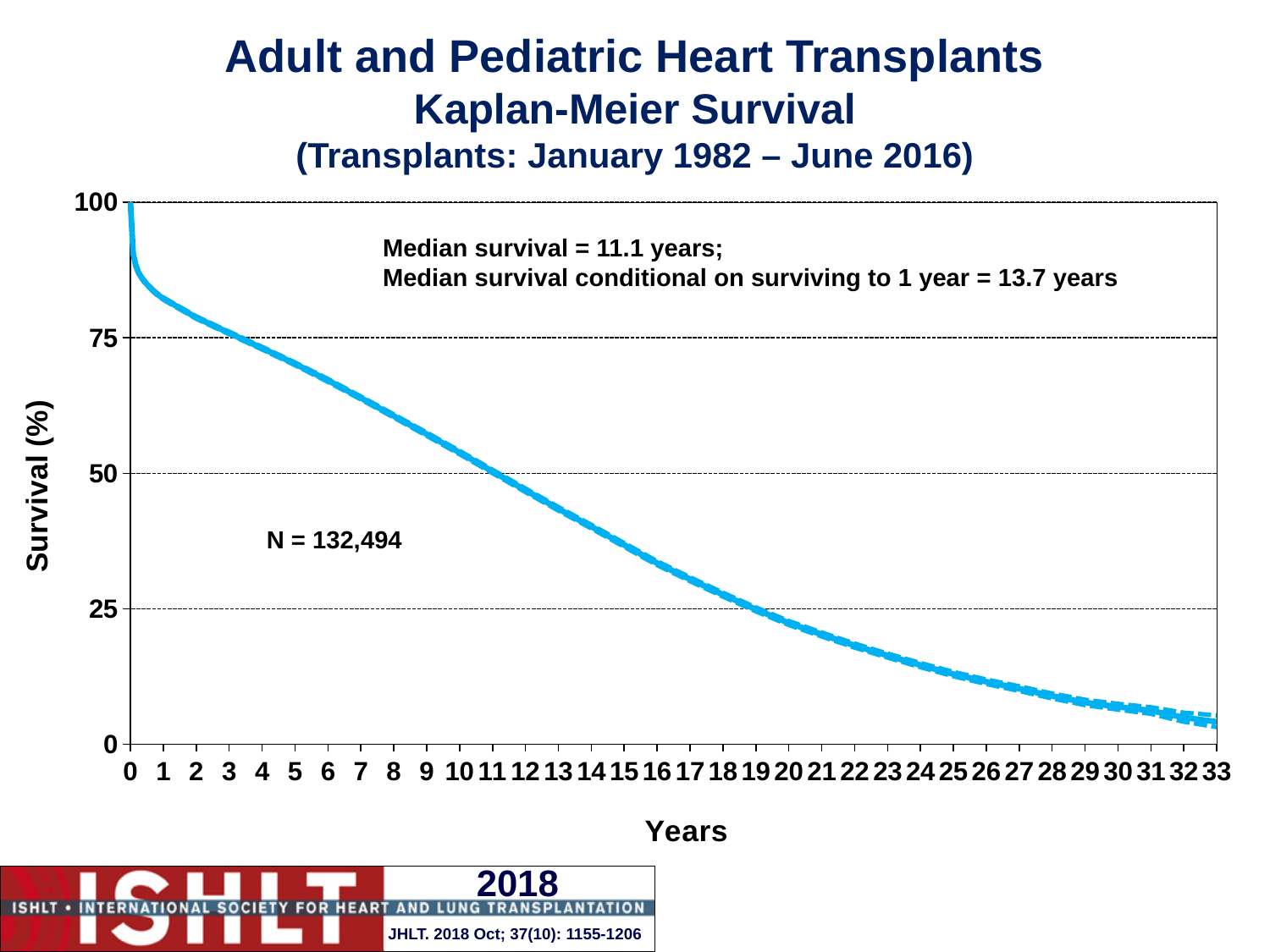
What is the median survival stated on the chart? 11.1 years What is the value of N shown on the chart? 132,494 What is the label of the y axis? Survival (%) Is the survival value at 30 years greater or less than 25? less Is the survival value at 15 years greater or less than 50? less Is the survival value at 20 years greater or less than 25? less What is the highest value shown on the x axis? 33 What kind of chart is shown on the slide? line chart What is the median survival conditional on surviving to 1 year, as stated on the chart? 13.7 years Does the survival curve rise or fall as the years increase along the x axis? fall